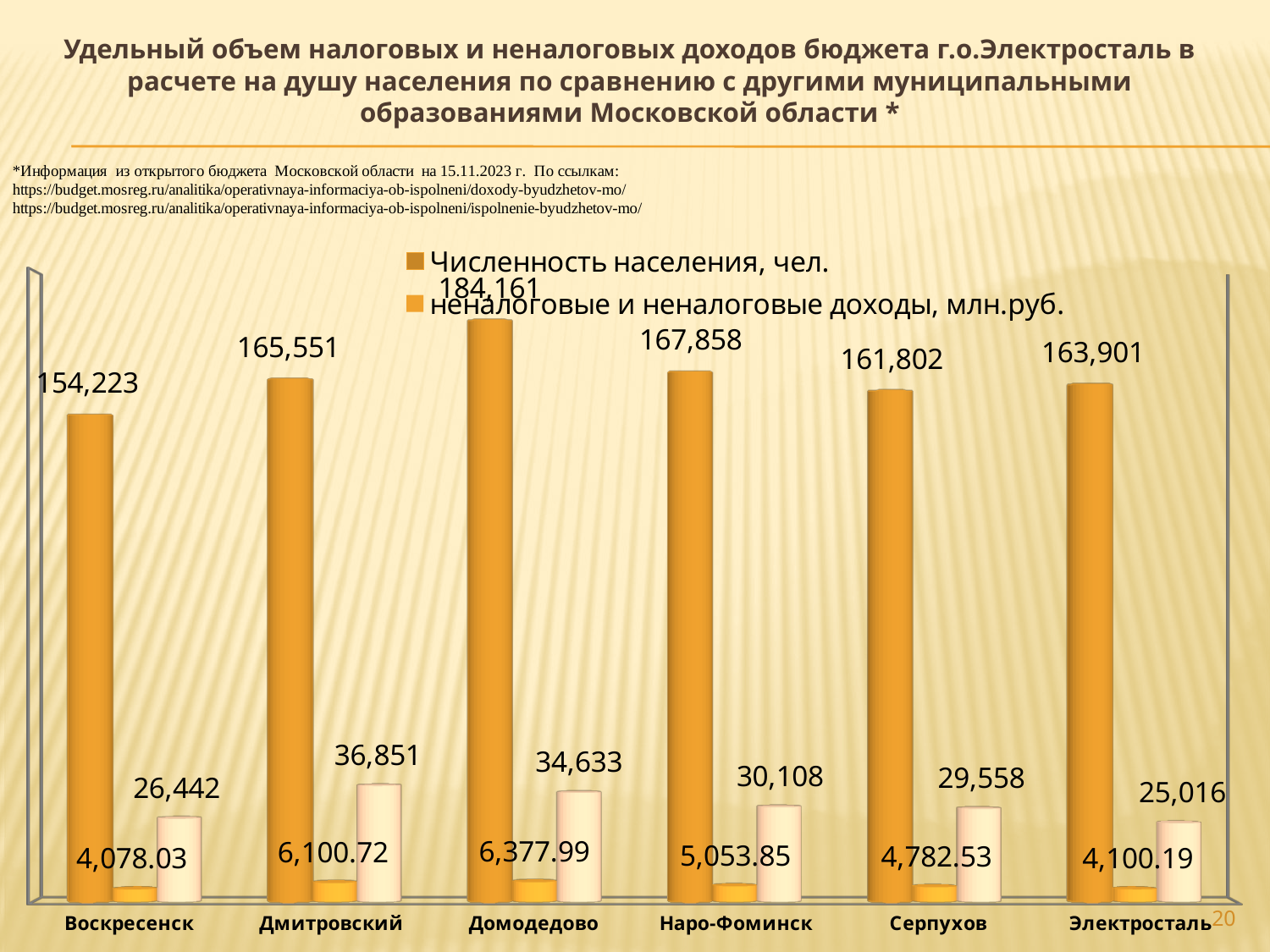
Which has higher tax and non-tax revenues (млн.руб.): Дмитровский or Наро-Фоминск? Дмитровский What is the value of tax and non-tax revenues (млн.руб.) shown for Электросталь? 4,100.19 How many municipalities are shown on the x axis of the chart? 6 Which municipality has the lowest tax and non-tax revenues (млн.руб.)? Воскресенск What is the population (Численность населения, чел.) shown for Серпухов? 161,802 What kind of chart is shown on the slide? Bar chart Which municipality has the highest population (Численность населения, чел.)? Домодедово What is the difference in tax and non-tax revenues (млн.руб.) between Домодедово and Дмитровский? 277.27 Which municipality has the lowest population (Численность населения, чел.)? Воскресенск What is the difference in population between Домодедово and Воскресенск? 29,938 Which municipality has the highest tax and non-tax revenues (млн.руб.)? Домодедово What is the population (Численность населения, чел.) shown for Домодедово? 184,161